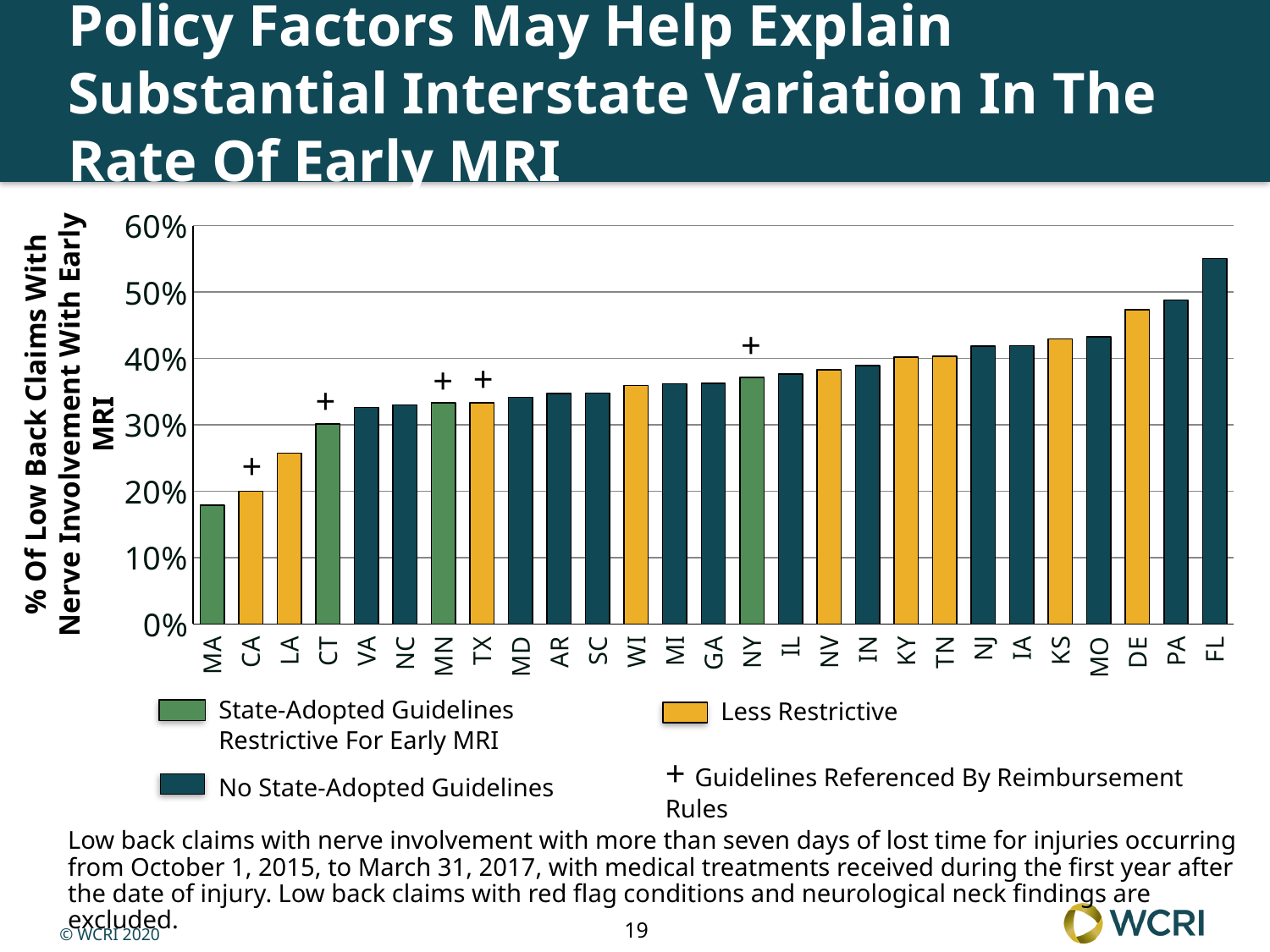
How many states are marked with a + symbol indicating guidelines referenced by reimbursement rules? 5 Is the value for NY greater or less than 40%? less Is the value for FL greater or less than 50%? greater How many states are shown on the x axis of the chart? 27 According to the legend, what do the green bars represent? State-Adopted Guidelines Restrictive For Early MRI Do the values generally rise or fall moving from left to right along the x axis? rise Which state has the larger value, KS or LA? KS Is the value for MA greater or less than 20%? less Which state has the lowest rate of early MRI in the chart? MA Which state has the highest rate of early MRI in the chart? FL What kind of chart is shown on the slide? bar chart